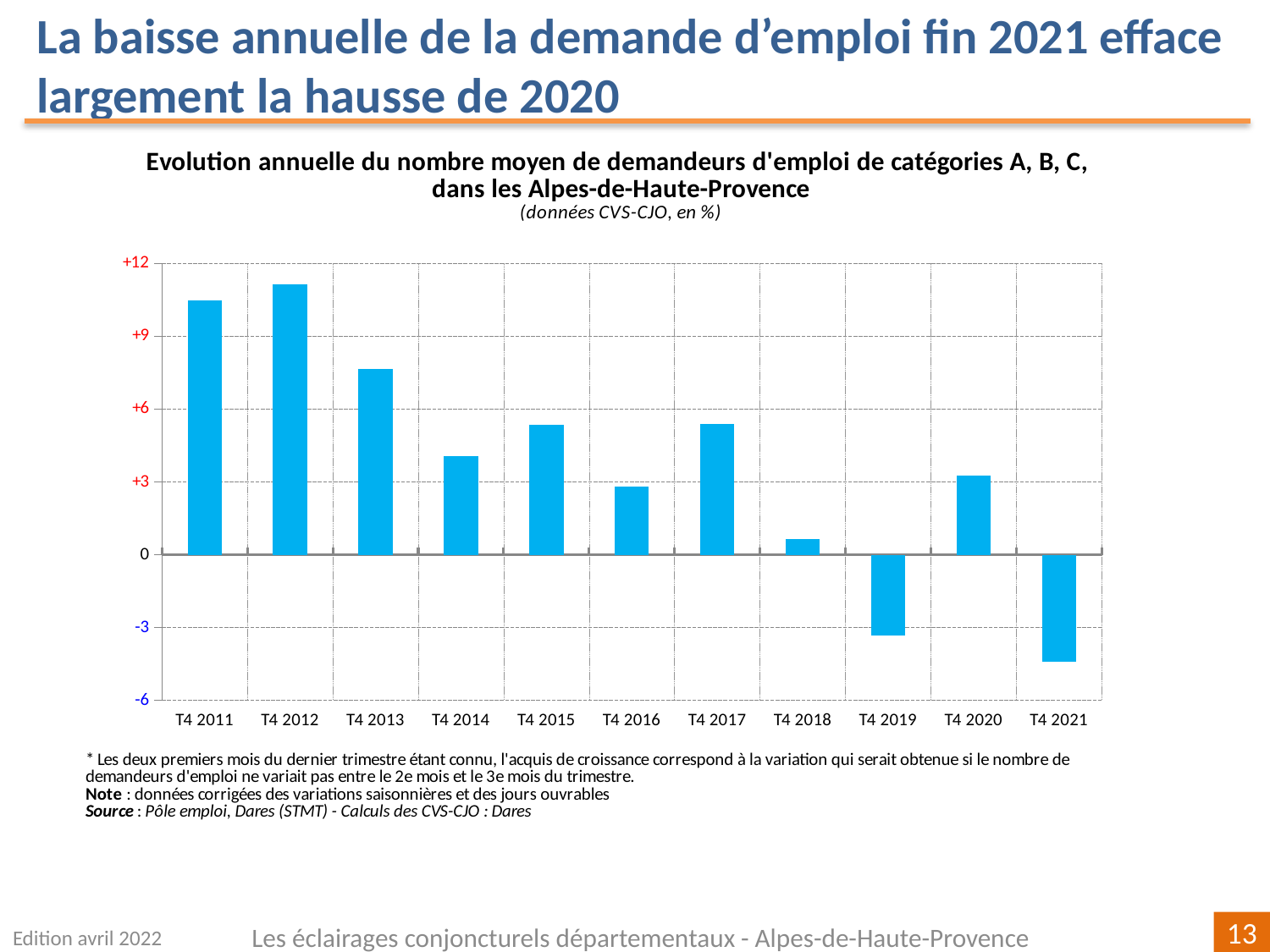
Is the value for T4 2019 greater or less than 0? less Overall, do the values rise or fall from T4 2011 to T4 2021? Fall How many quarters (categories) are plotted on the x axis? 11 Is the value for T4 2021 greater or less than -3? less Which is larger, the value for T4 2013 or the value for T4 2014? T4 2013 Is the value for T4 2016 greater or less than +3? less Which quarter has the highest annual change? T4 2012 Which quarter has the lowest annual change? T4 2021 What kind of chart is shown on the slide? Bar chart Which département does the chart title say the data refers to? Alpes-de-Haute-Provence